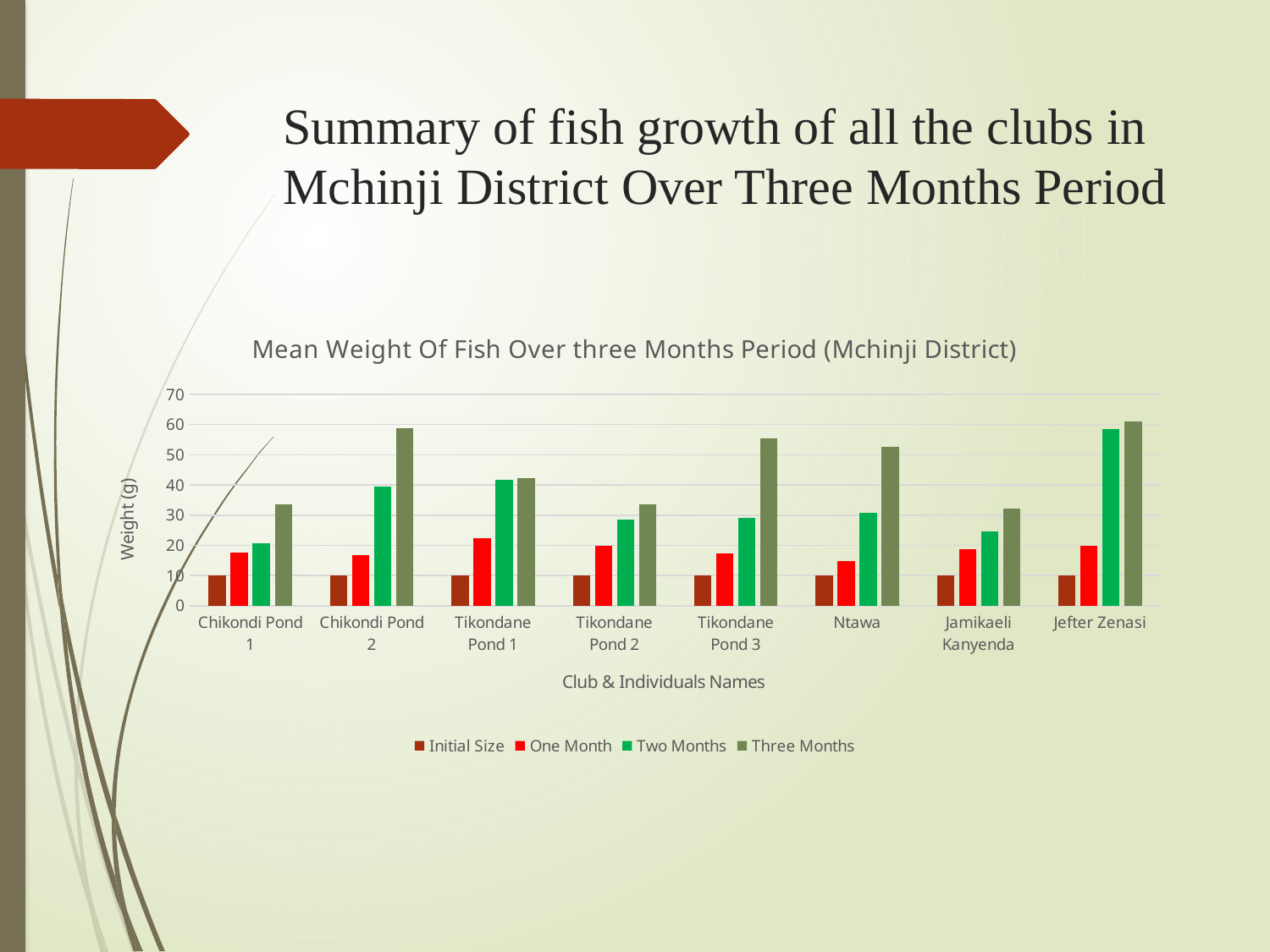
Is the Three Months value for Chikondi Pond 2 greater or less than 50? greater Which has the larger Three Months value, Tikondane Pond 2 or Tikondane Pond 3? Tikondane Pond 3 How many categories are shown on the x axis? 8 What kind of chart is shown on the slide? Bar chart Is the Three Months value for Chikondi Pond 1 greater or less than 40? less For Chikondi Pond 2, do the bars rise or fall from Initial Size to Three Months? rise How many series does the legend list? 4 What is the label of the vertical axis? Weight (g) Which category has the highest Two Months value? Jefter Zenasi Is the Two Months value for Jamikaeli Kanyenda greater or less than 30? less What is the title of the chart? Mean Weight Of Fish Over three Months Period (Mchinji District) What is the Initial Size value for Ntawa? 10